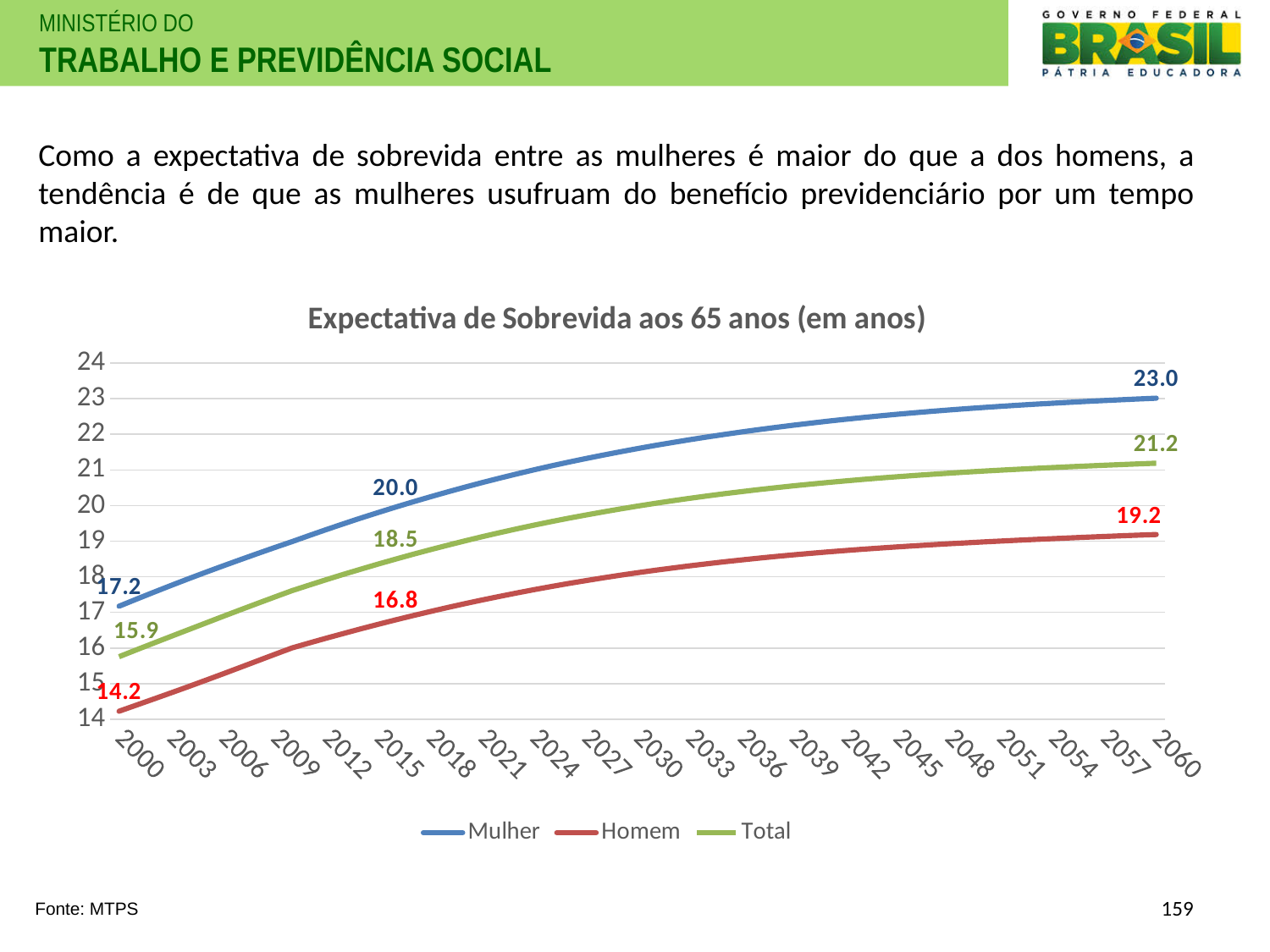
What is the value for Homem in 2060? 19.2 Which series has the highest value in 2060? Mulher What type of chart is shown on the slide? line chart What is the value for Homem in 2000? 14.2 Which series has the lowest value in 2000? Homem What is the difference between the Mulher and Homem values in 2060? 3.8 Do the values for Total rise or fall from 2000 to 2060? rise What is the title of the chart? Expectativa de Sobrevida aos 65 anos (em anos) What is the value for Total in 2015? 18.5 What is the value for Mulher in 2060? 23.0 Which is larger in 2015, the value for Mulher or the value for Total? Mulher How many series does the legend list? 3